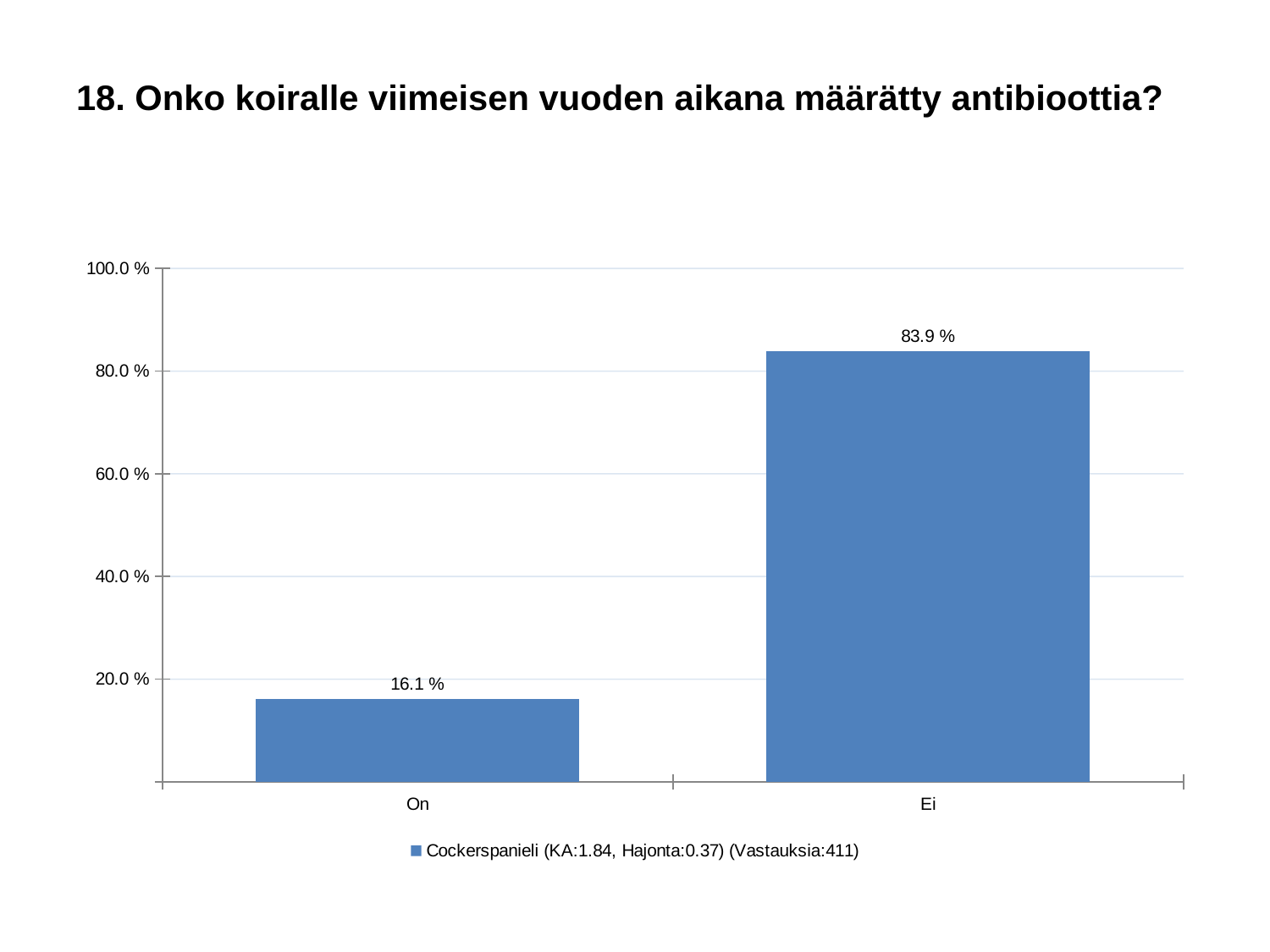
Is the value for "On" greater or less than 20.0 %? less How many series does the legend list? 1 Which category has the highest value? Ei What is the value for "Ei"? 83.9 % What kind of chart is shown on the slide? Bar chart How many categories are shown on the x axis? 2 What is the difference between the values for "Ei" and "On"? 67.8 % Which category has the lowest value? On Is the value for "Ei" greater or less than 80.0 %? greater Which is larger, the value for "On" or the value for "Ei"? Ei How many responses (Vastauksia) does the legend entry report? 411 What is the value for "On"? 16.1 %